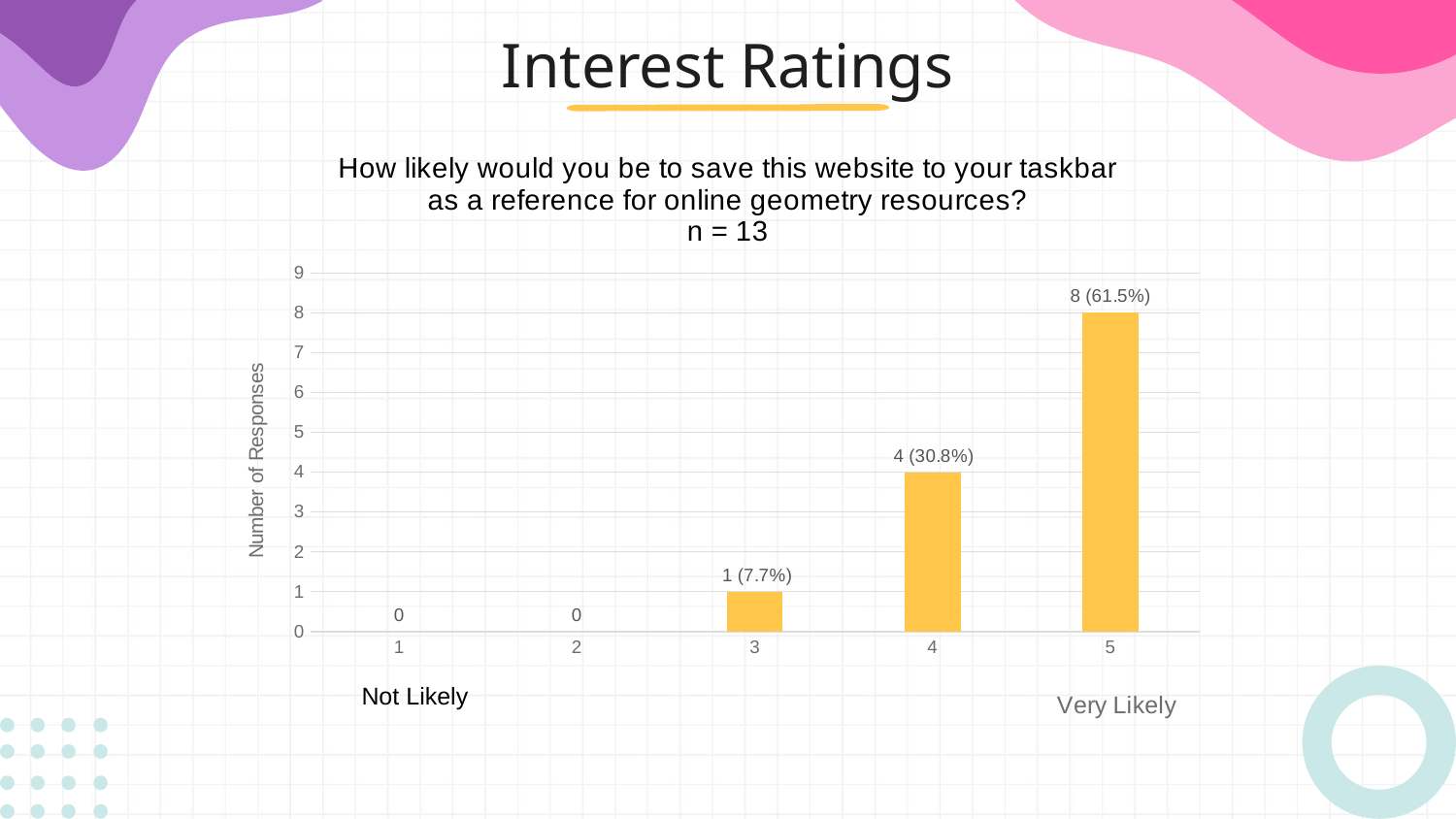
How many rating categories are shown on the x axis? 5 Which rating received the most responses? 5 What is the difference in number of responses between rating 5 and rating 4? 4 What is the sample size (n) stated above the chart? n = 13 How many responses were given for rating 5? 8 (61.5%) Which received more responses, rating 3 or rating 4? Rating 4 How many responses were given for rating 1? 0 How many responses were given for rating 4? 4 (30.8%) Do the number of responses rise or fall as the rating increases from 1 to 5? Rise What is the label on the y axis of the chart? Number of Responses How many responses were given for rating 3? 1 (7.7%) What kind of chart is shown on the slide? Bar chart